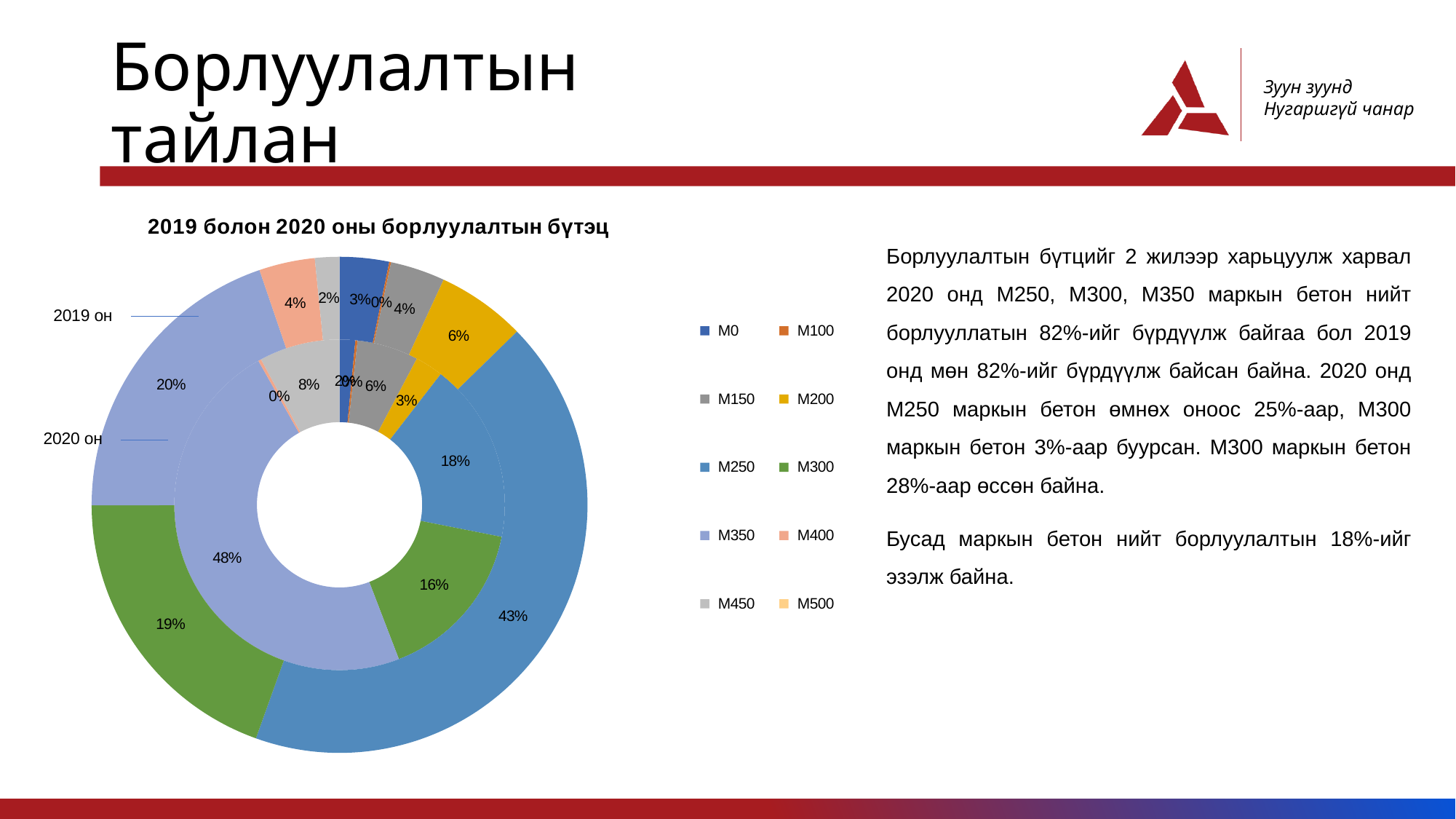
How many rings (years) does the doughnut chart show? 2 Which category has the largest share in the outer ring (2019 он)? M250 In the outer ring (2019 он), what share does M200 have? 6% In the inner ring (2020 он), what share does M450 have? 8% What is the title of the chart? 2019 болон 2020 оны борлуулалтын бүтэц In the inner ring (2020 он), what share does M350 have? 48% How many entries does the chart legend list? 10 What is the difference in percentage points between the M250 share in the outer ring (43%) and in the inner ring (18%)? 25 What kind of chart is shown on the slide? Doughnut chart In the inner ring (2020 он), which is larger: the share of M250 or the share of M300? M250 In the outer ring (2019 он), what share does M250 have? 43% Which category has the largest share in the inner ring (2020 он)? M350